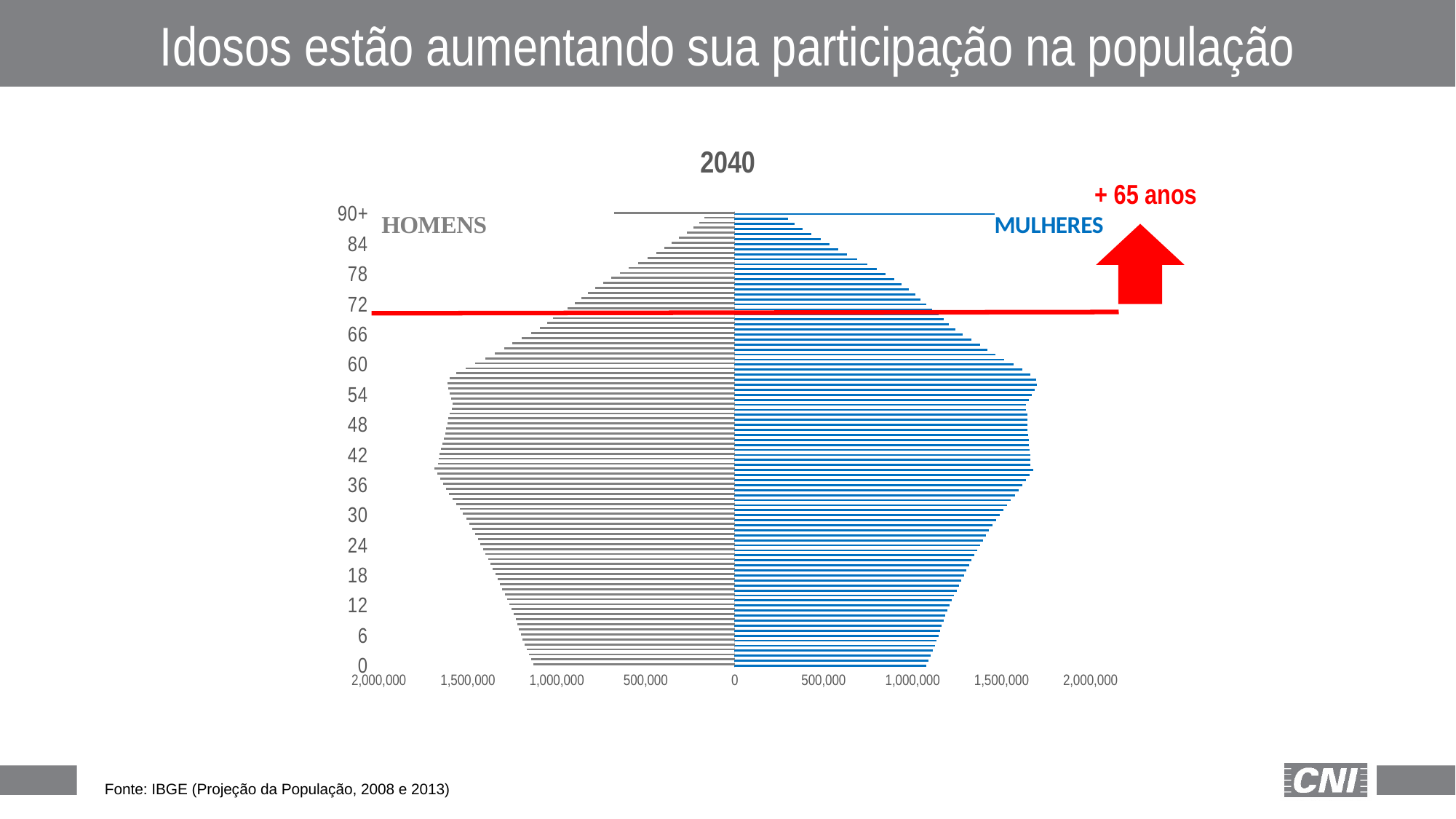
Is the value for MULHERES at age 0 greater or less than 500,000? greater Is the value for MULHERES at age 78 greater or less than 1,000,000? less Is the value for HOMENS at age 0 greater or less than 500,000? greater Which colour represents MULHERES in the chart? Blue At age 84, which is larger, the value for HOMENS or for MULHERES? MULHERES What kind of chart is shown on the slide? Bar chart (population pyramid) How many series does the chart show? 2 Do the bars for HOMENS get longer or shorter as age increases from 54 to 90+? Shorter What is the title of the chart? 2040